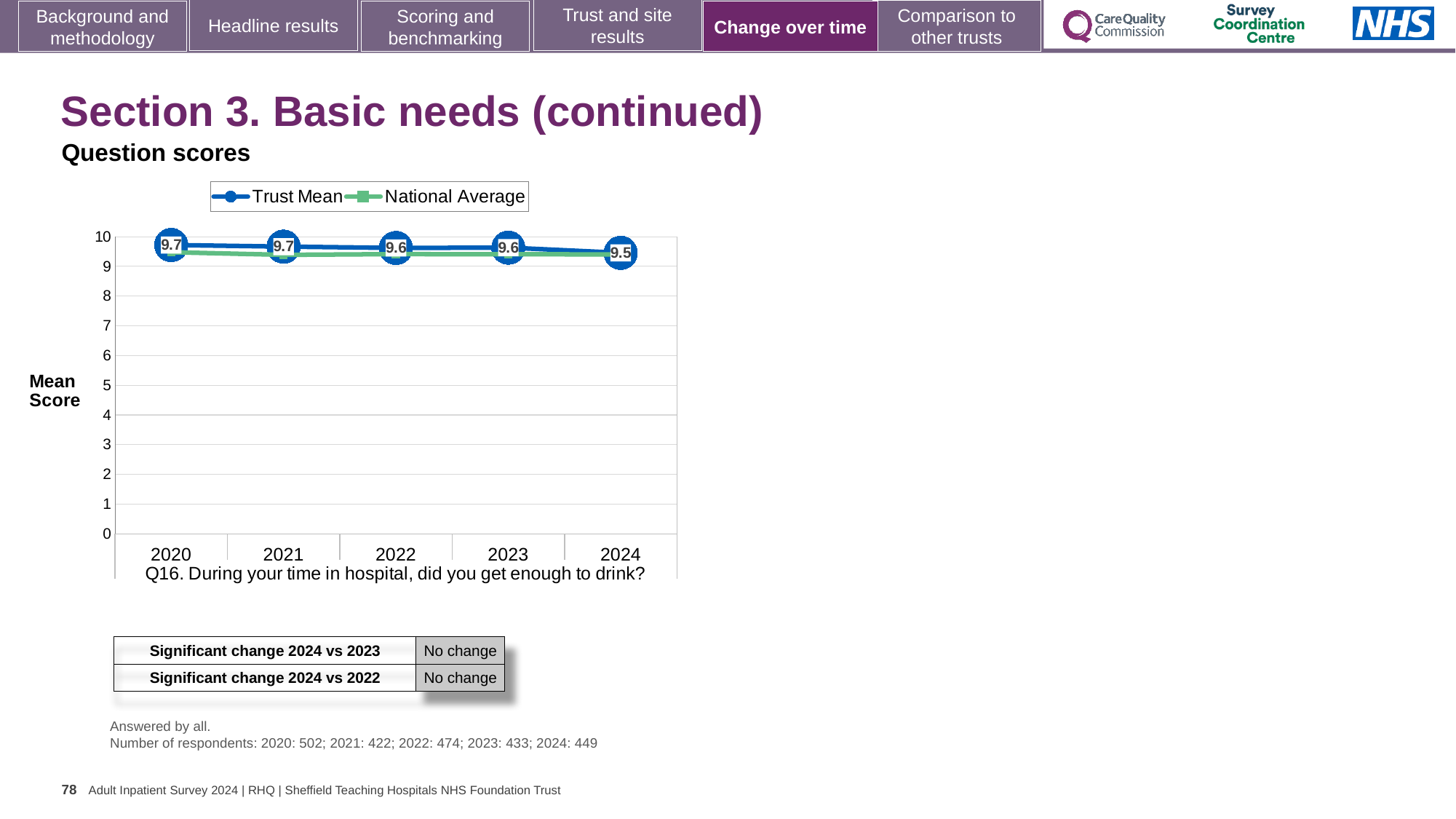
Does the Trust Mean rise or fall from 2020 to 2024? Fall What is the Trust Mean score for 2020? 9.7 What is the difference between the Trust Mean in 2020 and in 2024? 0.2 Which series are listed in the chart legend? Trust Mean and National Average Which survey question does the chart show scores for? Q16. During your time in hospital, did you get enough to drink? What is the Trust Mean score for 2022? 9.6 How many series does the legend list? 2 Is the National Average value for 2024 greater or less than 9? greater What kind of chart is shown on the slide? Line chart How many years are plotted on the x axis? 5 What is the Trust Mean score for 2024? 9.5 What is the Trust Mean score for 2023? 9.6